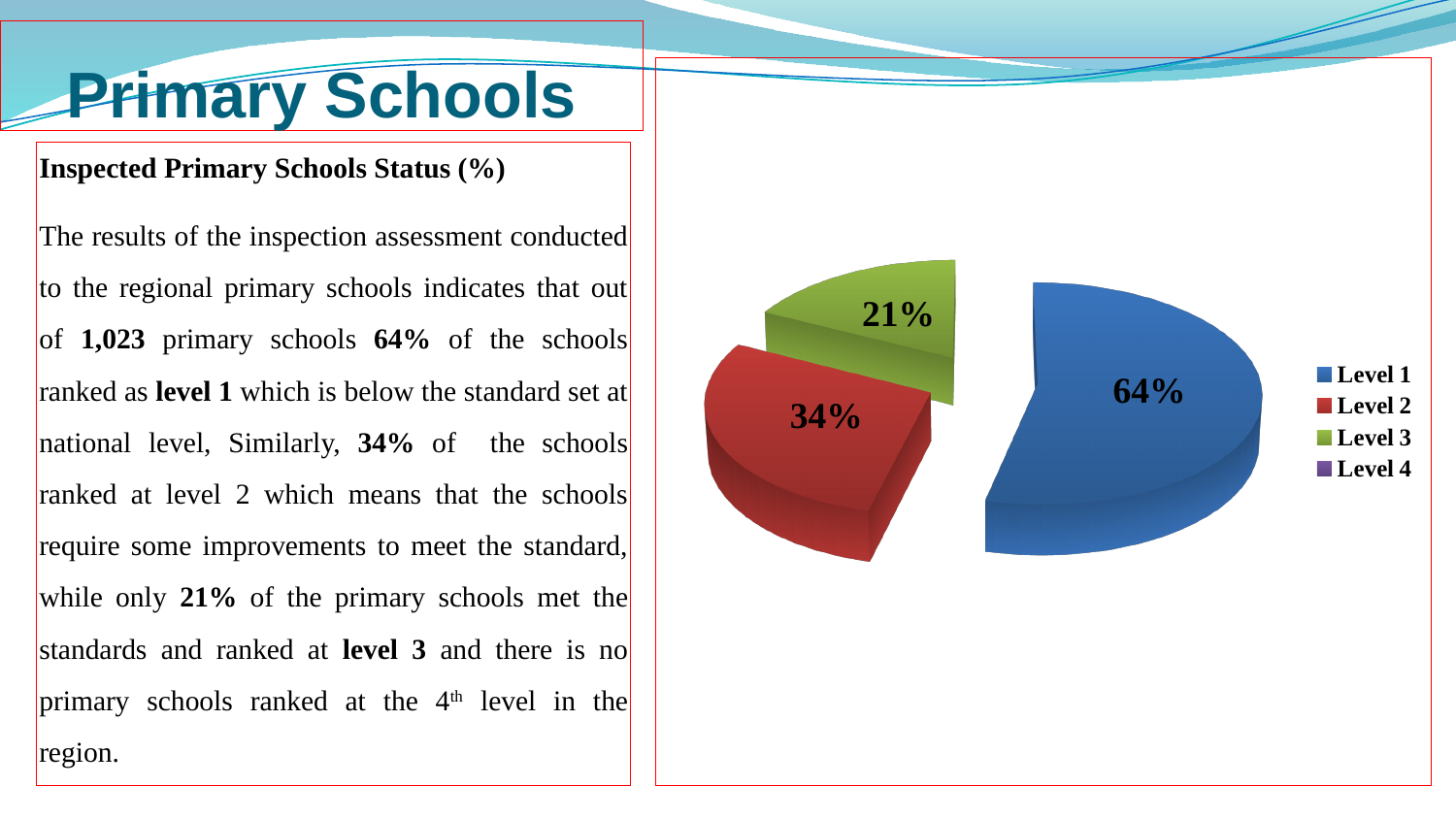
What is the difference in percentage points between Level 2 and Level 3? 13 What percentage of inspected primary schools are at Level 3? 21% Which level has the largest share of the pie? Level 1 What is the difference in percentage points between Level 1 and Level 2? 30 What percentage of inspected primary schools are at Level 1? 64% What kind of chart is shown on the slide? pie chart What colour is the Level 1 slice? blue Which level has the smallest visible slice in the pie? Level 3 Which legend entry has no visible slice in the pie? Level 4 How many entries does the legend list? 4 What percentage of inspected primary schools are at Level 2? 34% Which is larger, the share for Level 2 or the share for Level 3? Level 2